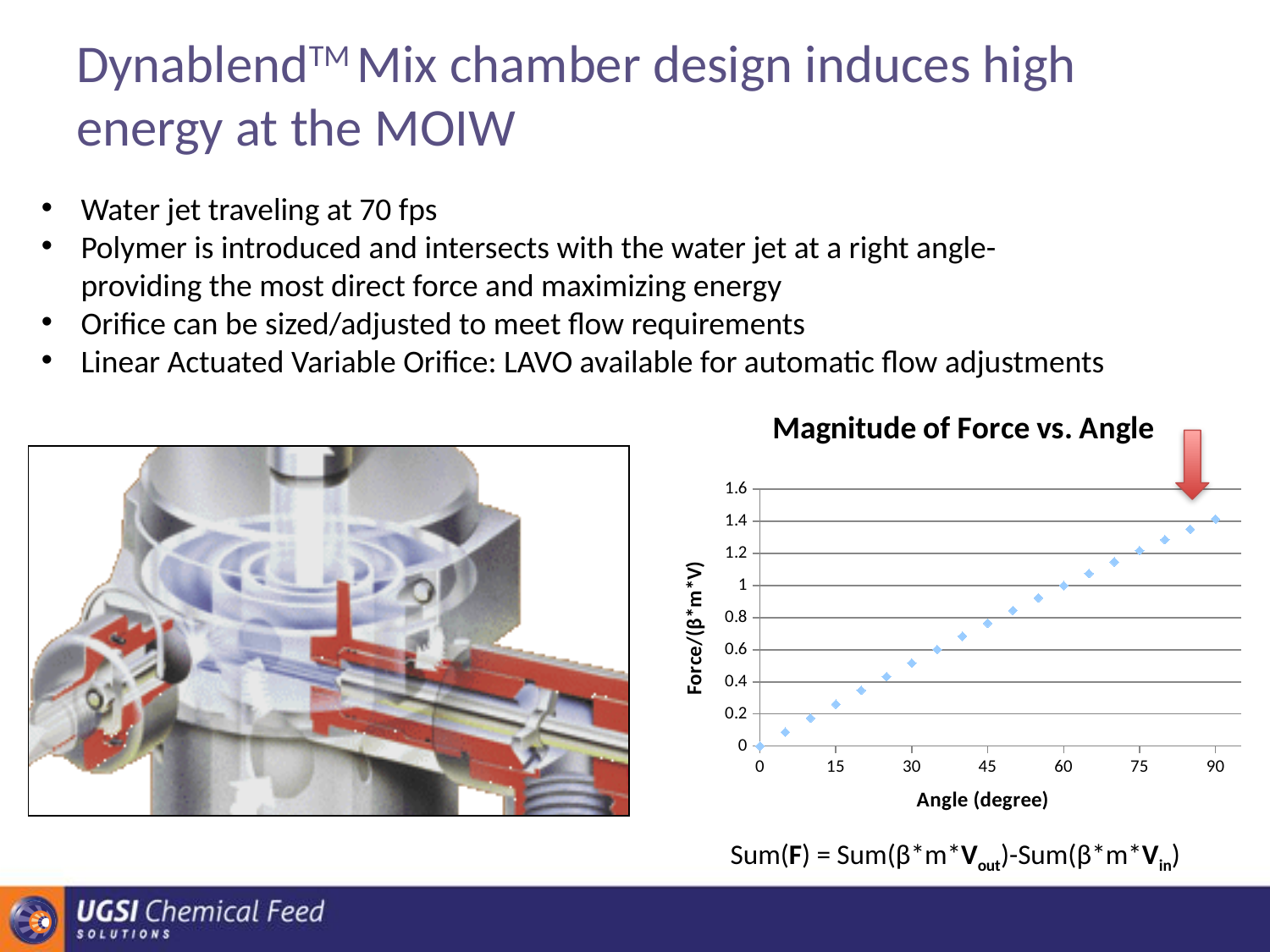
What is the title of the chart? Magnitude of Force vs. Angle What is the plotted value at an angle of 0 degrees? 0 What is the label of the x axis of the chart? Angle (degree) How many data points are plotted on the chart? 19 At which angle is the plotted force value highest? 90 Is the plotted value at 30 degrees greater or less than 0.6? less Which angle has the larger plotted value, 30 degrees or 75 degrees? 75 degrees At which angle is the plotted force value lowest? 0 What kind of chart is shown on the slide? scatter chart Do the plotted values rise or fall as the angle increases from 0 to 90 degrees? rise What is the plotted value at an angle of 60 degrees? 1 Is the plotted value at 90 degrees greater or less than 1.2? greater